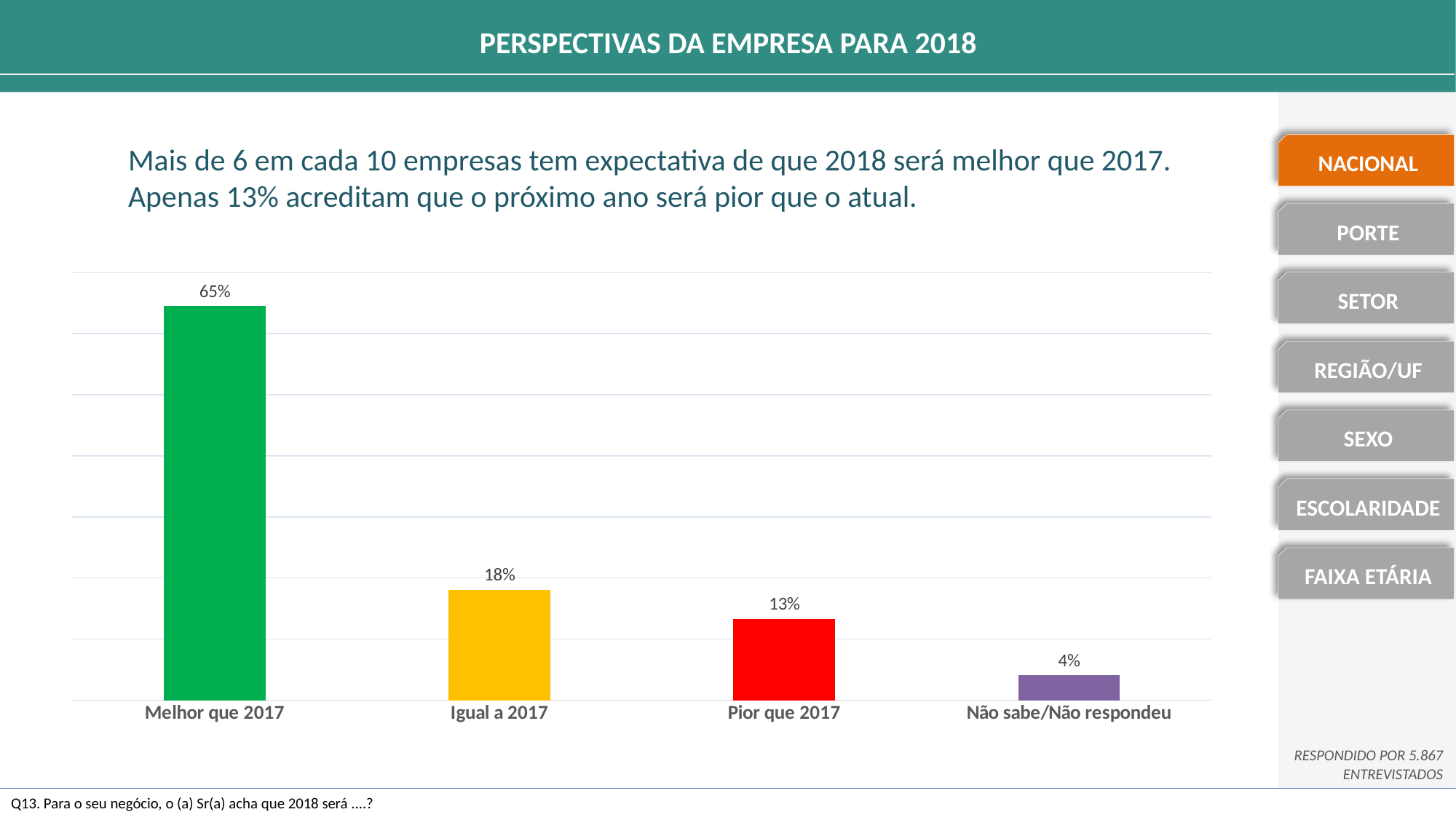
What is the difference between the values for "Melhor que 2017" and "Igual a 2017"? 47% Which category has the lowest value? Não sabe/Não respondeu What is the value for "Melhor que 2017"? 65% What kind of chart is shown on the slide? Bar chart What is the value for "Igual a 2017"? 18% What is the value for "Não sabe/Não respondeu"? 4% What is the difference between the values for "Igual a 2017" and "Pior que 2017"? 5% Which is larger, the value for "Pior que 2017" or the value for "Não sabe/Não respondeu"? Pior que 2017 Which category has the highest value? Melhor que 2017 How many categories are shown on the chart? 4 What colour is the bar for "Pior que 2017"? Red What is the value for "Pior que 2017"? 13%